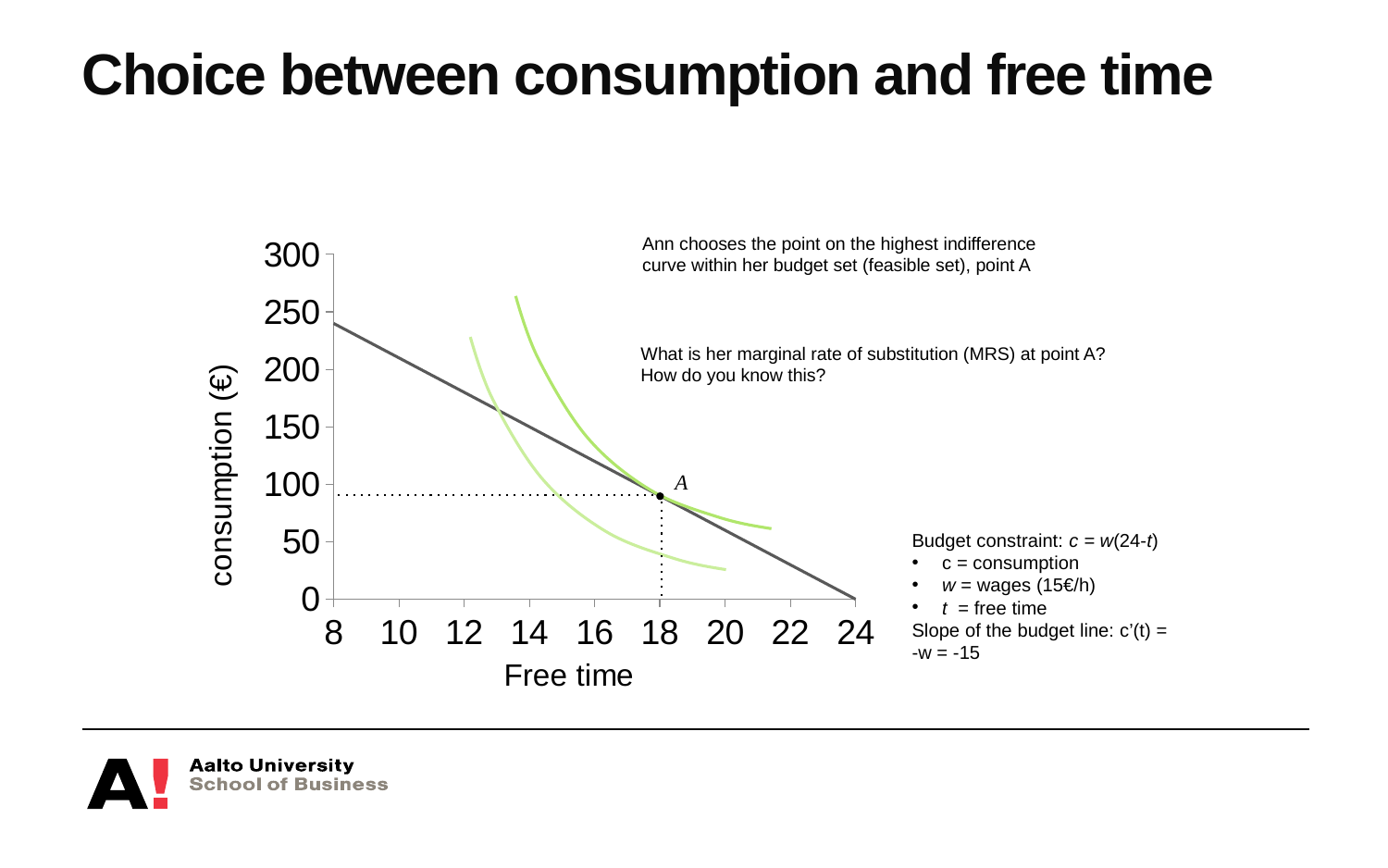
How many tick labels are shown on the Free time axis? 9 Is the consumption value on the budget line at free time 8 greater or less than 200? greater How many indifference curves (green curves) are drawn on the chart? 2 Is the consumption value at point A greater or less than 50? greater Does the budget line rise or fall as free time increases? fall At what free time value does the budget line reach a consumption of 0? 24 What is the free time value at point A? 18 Is the consumption value at point A greater or less than 100? less Which is higher on the budget line: consumption at free time 8 or at free time 24? free time 8 What kind of chart is shown on the slide? line chart What is the label of the horizontal axis? Free time According to the slide, what is the slope of the budget line? -15